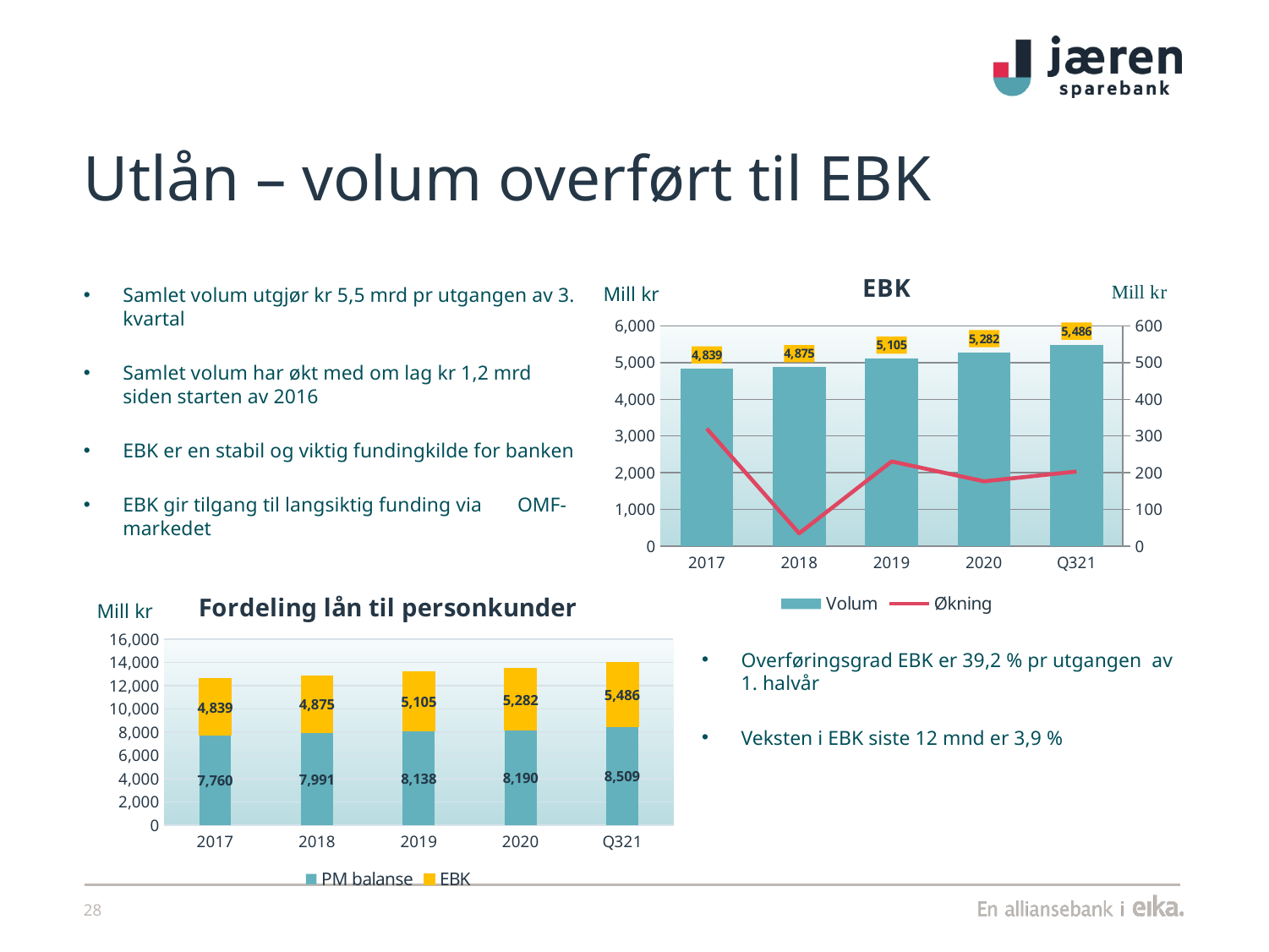
In the EBK chart, how many series does the legend list? 2 What type of chart is the Fordeling lån til personkunder chart? stacked bar chart In the Fordeling lån til personkunder chart, how many categories are shown on the x axis? 5 In the EBK chart, in which year is the Økning line at its lowest? 2018 In the EBK chart, which year has the highest Volum? Q321 In the EBK chart, is the Økning value for 2018 greater or less than 100? less In the Fordeling lån til personkunder chart, which is larger in 2018: PM balanse or EBK? PM balanse In the EBK chart, what is the Volum value for 2019? 5,105 In the EBK chart, what is the difference in Volum between Q321 and 2017? 647 In the Fordeling lån til personkunder chart, what is the PM balanse value for 2020? 8,190 In the Fordeling lån til personkunder chart, what is the total of the stacked bar for Q321? 13,995 In the EBK chart, do the Volum bars rise or fall from 2017 to Q321? rise